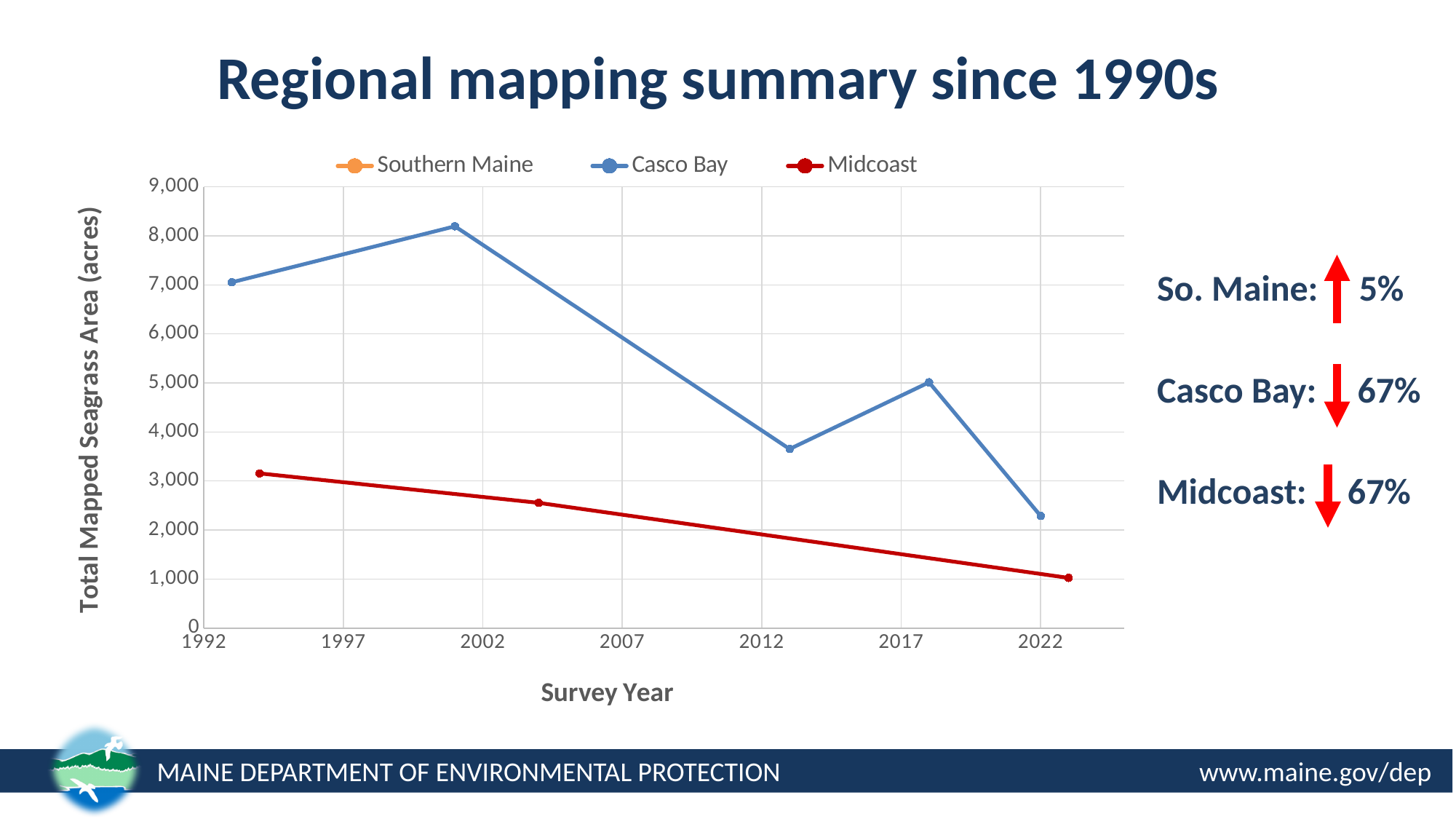
What is the label of the y axis? Total Mapped Seagrass Area (acres) At the most recent survey, which series has the larger mapped seagrass area, Casco Bay or Midcoast? Casco Bay Is the most recent Midcoast value greater or less than 2,000 acres? less What is the title of the chart slide? Regional mapping summary since 1990s Do the Midcoast values rise or fall over the survey years? fall Is the most recent Casco Bay value (around 2022) greater or less than 3,000 acres? less How many data points are plotted for the Midcoast series? 3 How many data points are plotted for the Casco Bay series? 5 What kind of chart is shown on the slide? line chart Is the earliest Casco Bay value greater or less than 6,000 acres? greater How many series does the legend list? 3